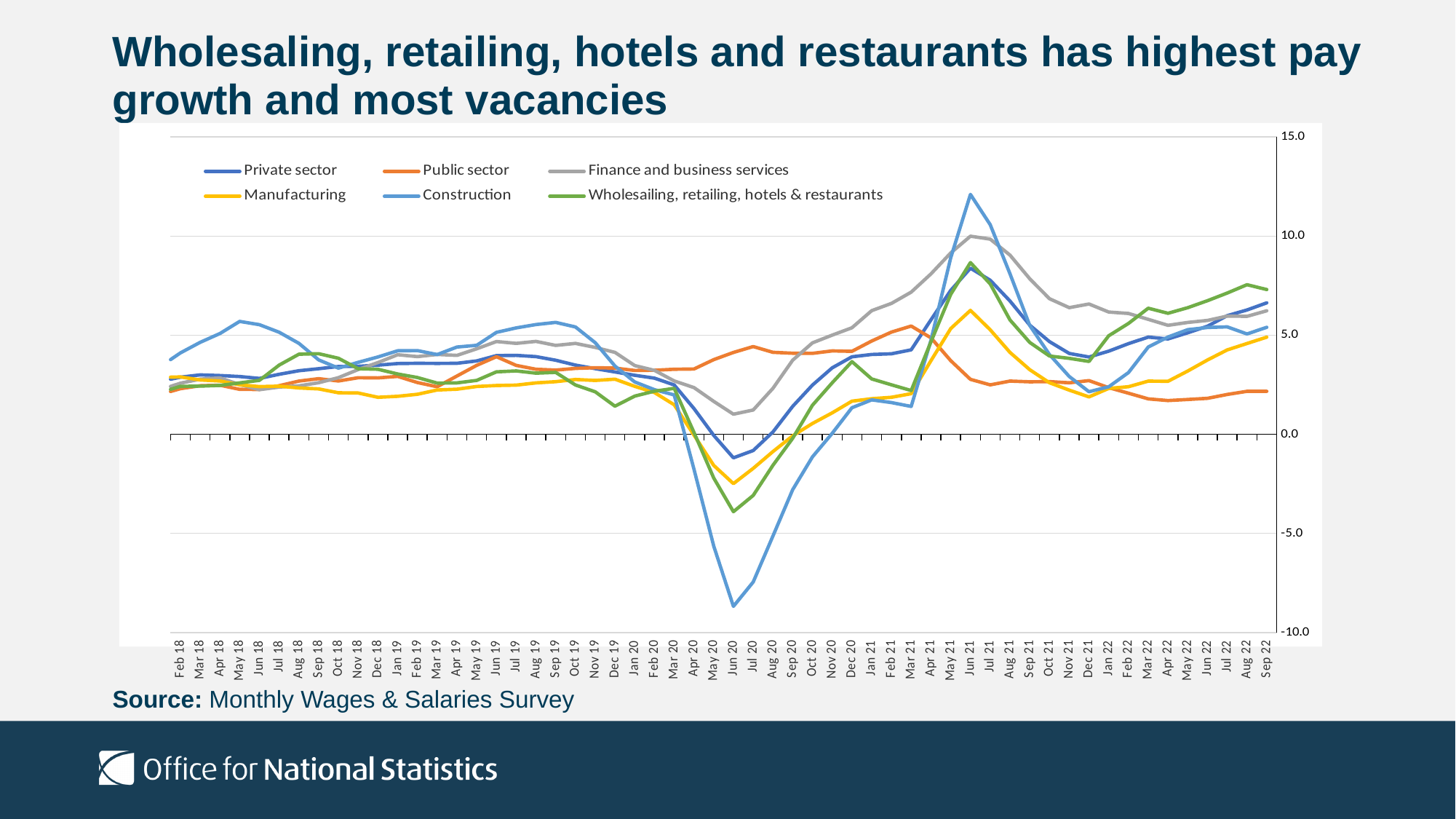
Which series reaches the lowest value anywhere on the chart? Construction What kind of chart is shown on the slide? Line chart How many series does the legend list? 6 Is the value for Private sector in Jun 20 greater or less than 0.0? less Which series reaches the highest value anywhere on the chart? Construction Does the Construction series rise or fall between Jun 20 and Jun 21? Rise Is the value for Construction in Jun 21 greater or less than 10.0? greater In Jun 20, which is larger: the value for Public sector or the value for Construction? Public sector What source is cited below the chart? Monthly Wages & Salaries Survey Is the value for Manufacturing in Jun 21 greater or less than 5.0? greater Which series has the lowest value at Sep 22? Public sector